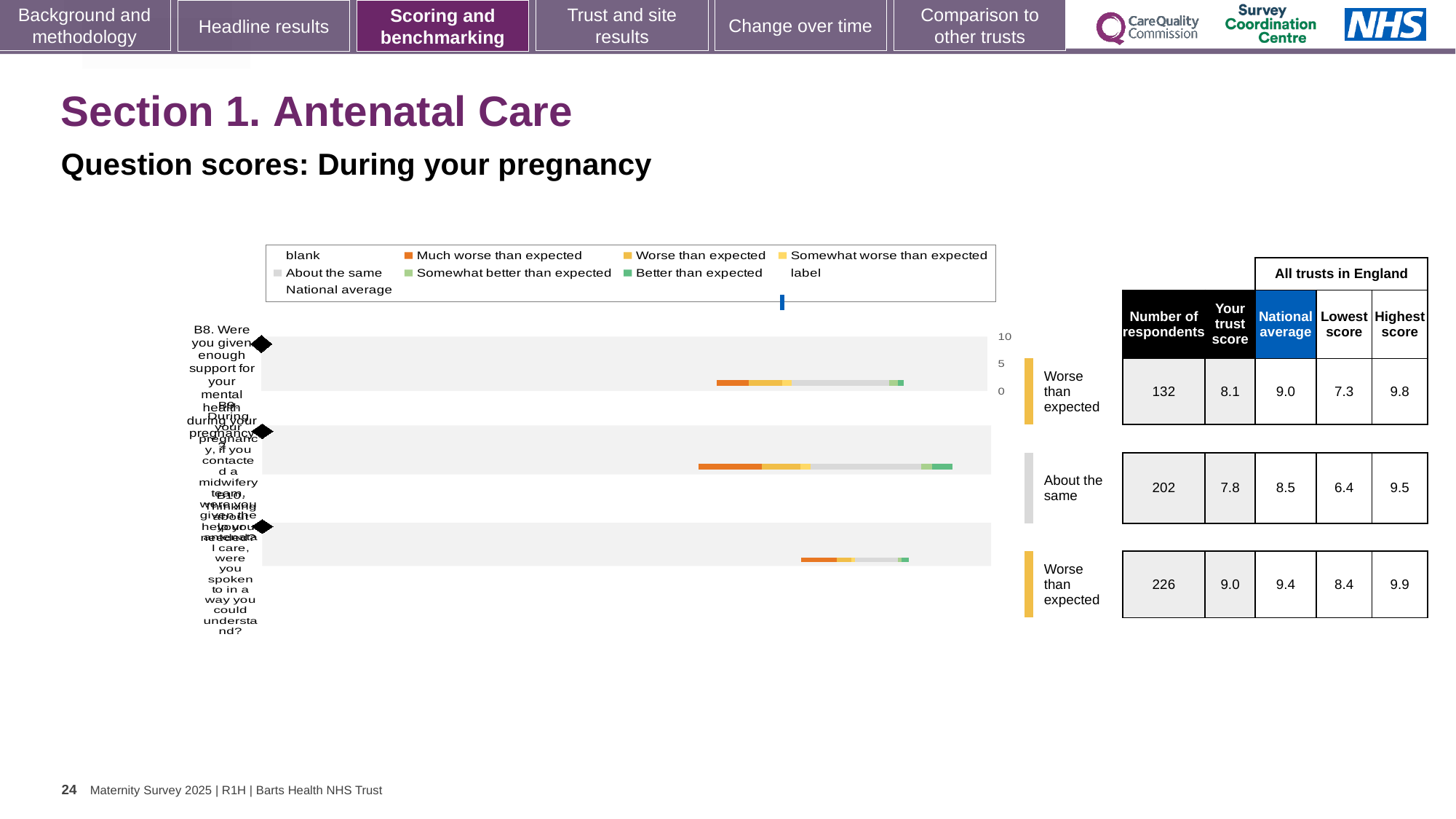
In the table beside the chart, what is the number of respondents for the first row (B8, support for your mental health during pregnancy)? 132 Which row of the table has the highest number of respondents? the third row (226) How many of the three rows are rated 'Worse than expected'? 2 Which is larger, the trust score for the second row or the trust score for the third row? the third row (9.0) In the table, what is the lowest score for the second row? 6.4 In the table beside the chart, what is the 'Your trust score' for the first row (B8)? 8.1 What benchmark rating is shown next to the second row of the table? About the same In the table beside the chart, what is the national average for the first row (B8)? 9.0 What kind of chart is shown on the slide? bar chart How many question bars are plotted in the chart? 3 For the first row (B8), what is the difference between the national average and the trust score? 0.9 In the table, what is the highest score for the third row? 9.9